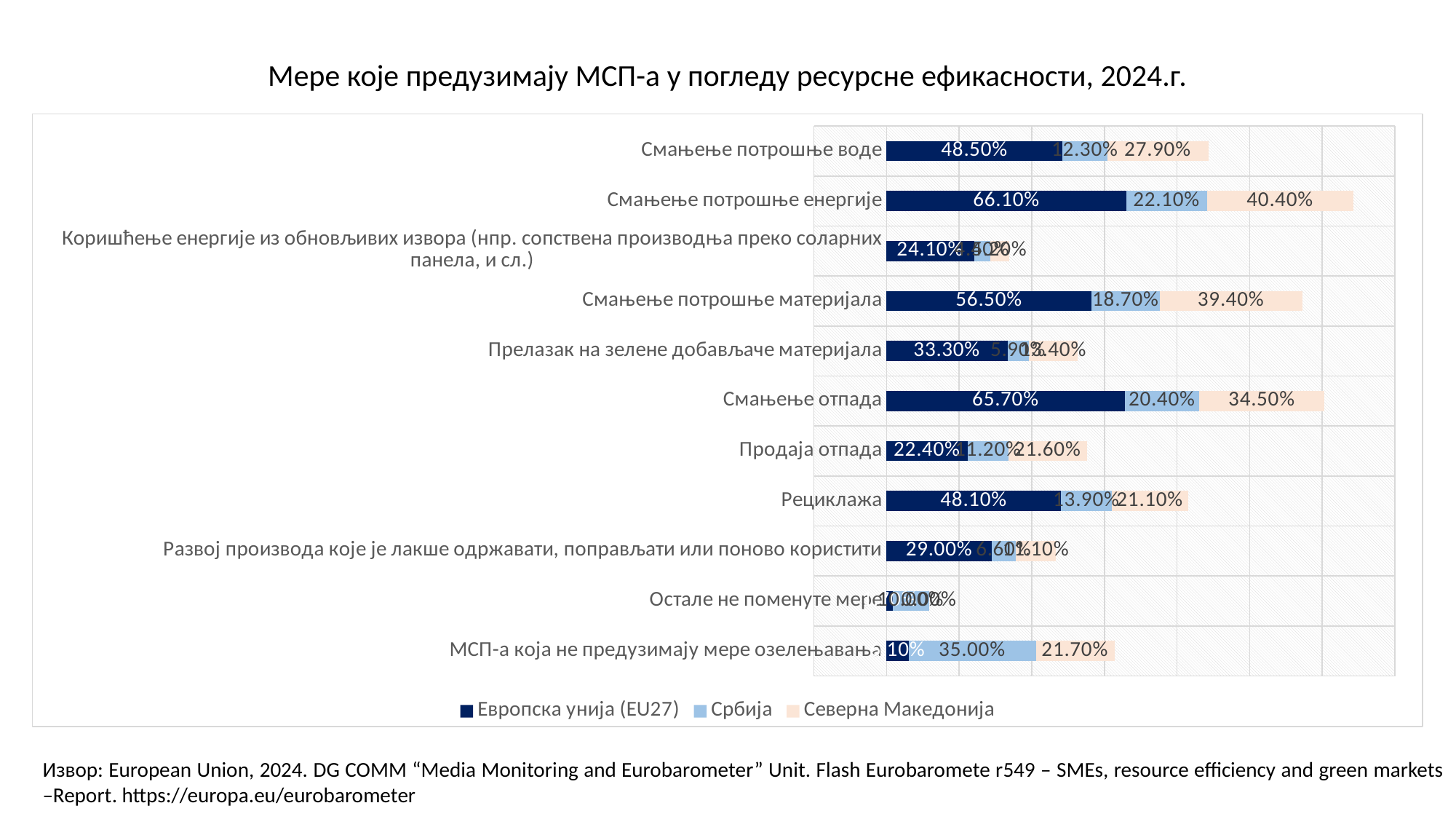
What is the value for Србија for МСП-а која не предузимају мере озелењавања? 35.00% What is the total of the stacked bar for Смањење отпада? 120.60% What kind of chart is shown on the slide? Stacked bar chart What is the value for Европска унија (EU27) for Смањење потрошње енергије? 66.10% Which category has the highest value for Северна Македонија? Смањење потрошње енергије What is the value for Северна Македонија for Смањење потрошње материјала? 39.40% What is the difference between the Европска унија (EU27) values for Смањење потрошње енергије and Смањење отпада? 0.40% How many series does the legend list? 3 Which category has the highest value for Србија? МСП-а која не предузимају мере озелењавања How many categories are shown on the chart? 11 What is the value for Србија for Смањење отпада? 20.40% For Продаја отпада, which is larger: the value for Србија or for Северна Македонија? Северна Македонија